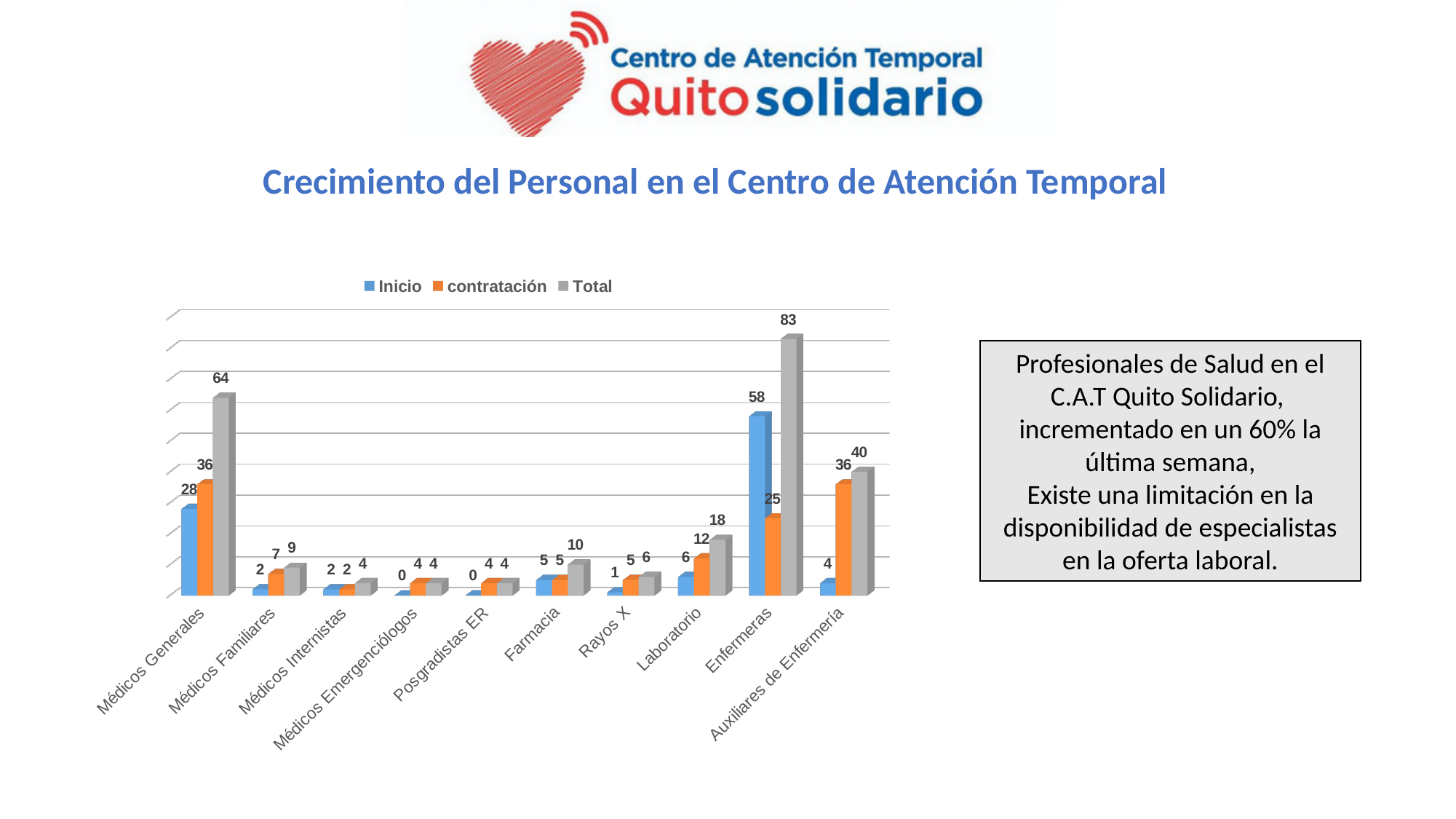
Which category has the highest contratación value? Médicos Generales and Auxiliares de Enfermería (tied at 36) Which is larger for Enfermeras: the Inicio value or the contratación value? Inicio What is the Inicio value for Médicos Generales? 28 What is the contratación value for Laboratorio? 12 How many categories are shown on the x axis? 10 Which category has the highest Total value? Enfermeras What is the title of the chart on the slide? Crecimiento del Personal en el Centro de Atención Temporal What is the Total value for Enfermeras? 83 How many series does the legend list? 3 What is the difference between the Total values for Enfermeras and Médicos Generales? 19 What kind of chart is shown on the slide? Bar chart What is the contratación value for Auxiliares de Enfermería? 36